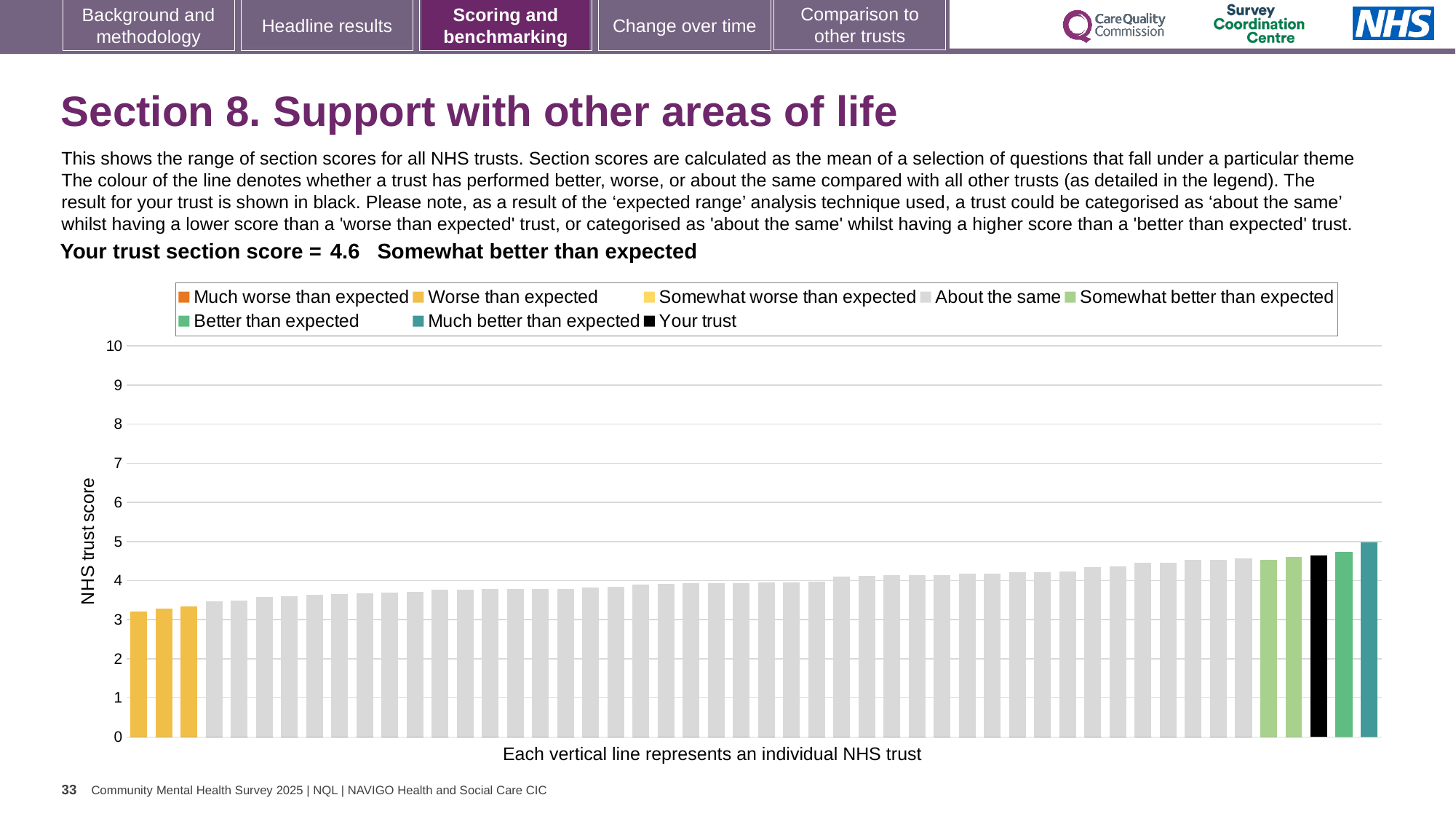
What is the label on the y axis of the chart? NHS trust score What colour is the bar representing your trust? Black Which category is your trust's section score placed in? Somewhat better than expected Is the value for the highest bar greater or less than 6? less Which legend category do the lowest bars belong to? Worse than expected Is the value for the lowest bar greater or less than 4? less What kind of chart is shown on the slide? Bar chart Which legend category does the highest bar belong to? Much better than expected How many entries does the chart legend list? 8 What is the section score for your trust? 4.6 Do the bar values rise or fall from left to right along the x axis? rise Is the value for your trust greater or less than 4? greater